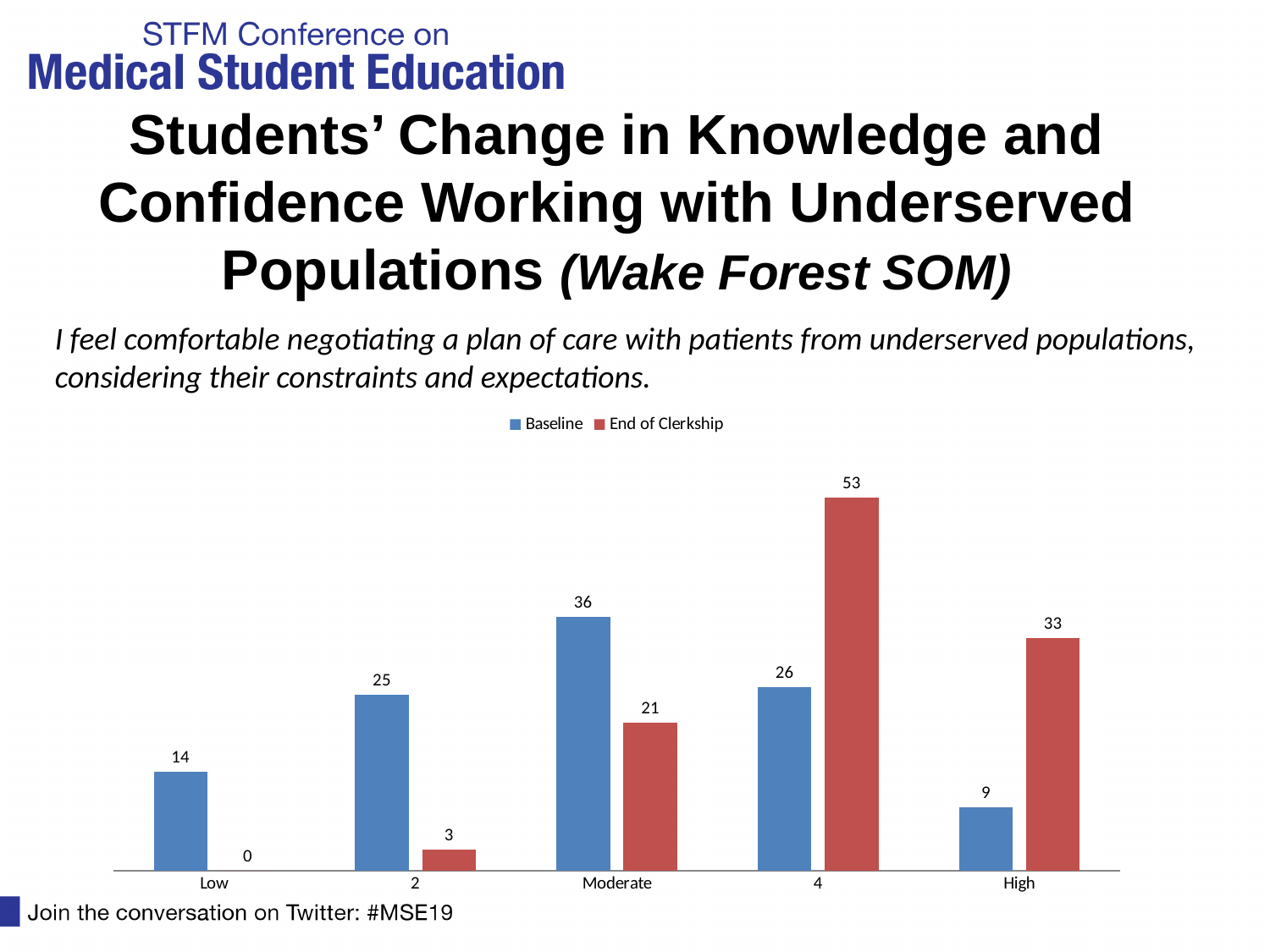
What is the Baseline value for the Low category? 14 Which colour represents the End of Clerkship series? Red For the Moderate category, which is larger: the Baseline value or the End of Clerkship value? Baseline How many categories are shown on the x axis? 5 Which category has the highest Baseline value? Moderate Which category has the lowest End of Clerkship value? Low What is the difference between the End of Clerkship and Baseline values for the High category? 24 What kind of chart is shown on the slide? Bar chart How many series does the legend list? 2 What is the End of Clerkship value for the Low category? 0 What is the Baseline value for the High category? 9 What is the End of Clerkship value for the 4 category? 53